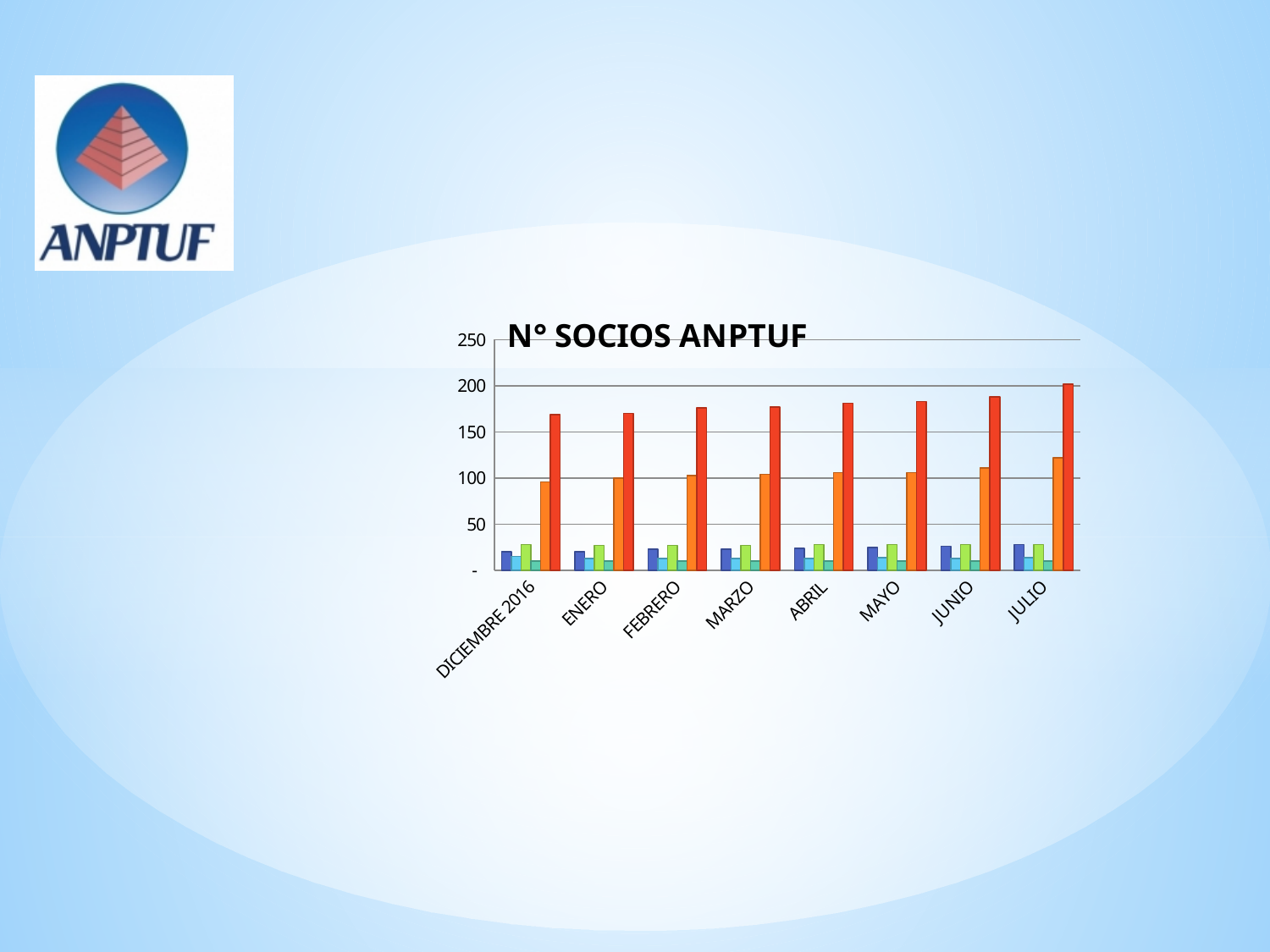
Do the red bars rise or fall from DICIEMBRE 2016 to JULIO? rise How many bars are plotted for each category in the chart? 6 In which category is the tallest orange bar found? JULIO In which category is the tallest red bar found? JULIO Is the value of the red bar for JULIO greater or less than 150? greater What kind of chart is shown on the slide? bar chart What is the title of the chart? N° SOCIOS ANPTUF How many categories are shown on the x axis of the chart? 8 For JULIO, which is larger: the red bar or the orange bar? the red bar Is the value of the orange bar for JUNIO greater or less than 100? greater Is the value of the red bar for DICIEMBRE 2016 greater or less than 200? less